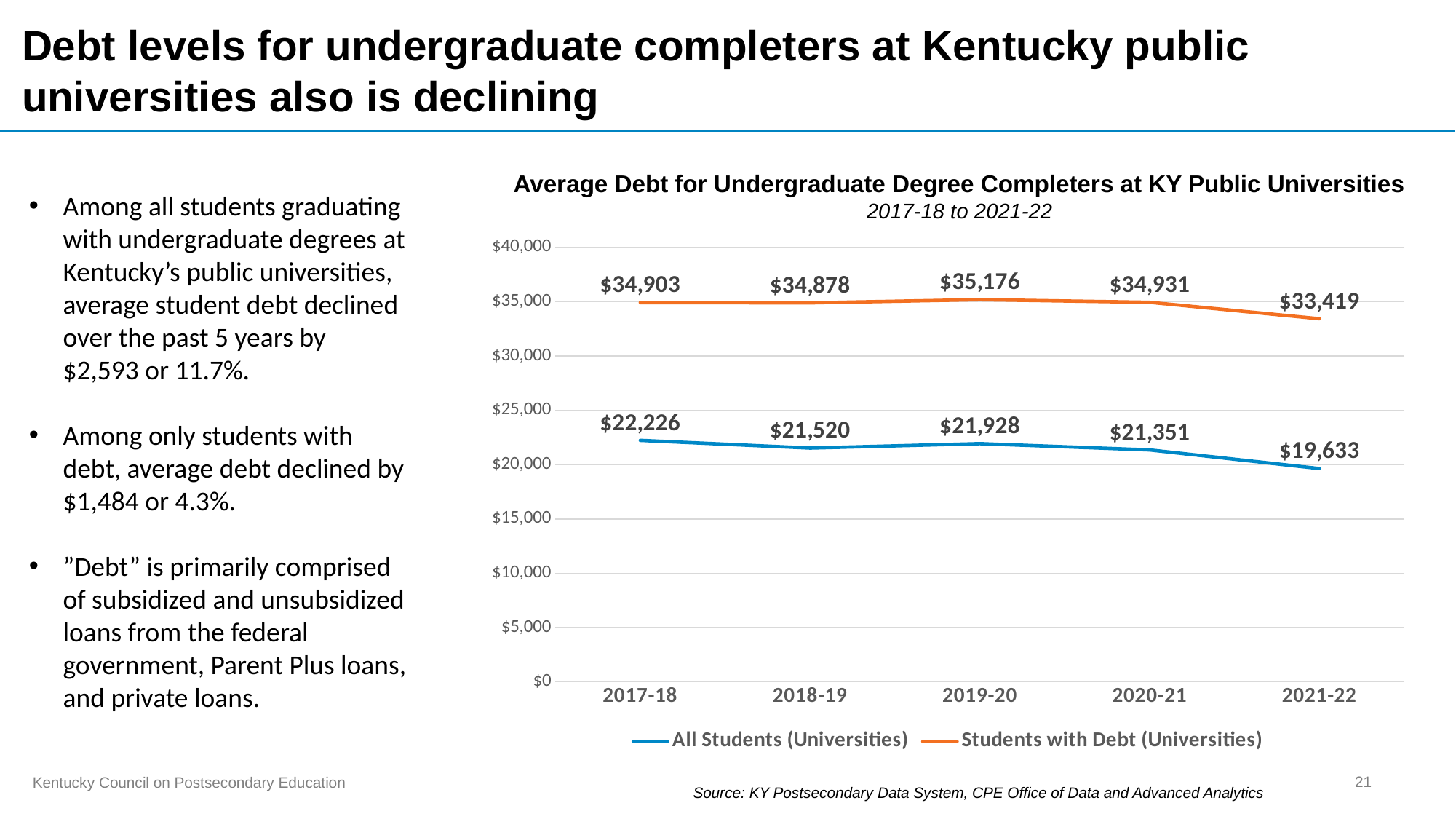
In which year is the average debt for Students with Debt (Universities) lowest? 2021-22 What is the difference between the Students with Debt and All Students values in 2021-22? $13,786 Which is larger: the All Students value in 2018-19 or in 2019-20? 2019-20 Is the value for Students with Debt (Universities) in 2021-22 greater or less than $35,000? less What is the average debt for All Students (Universities) in 2017-18? $22,226 What is the average debt for Students with Debt (Universities) in 2019-20? $35,176 By how much did the average debt for All Students (Universities) change from 2017-18 to 2021-22? $2,593 What kind of chart is shown on the slide? line chart In which year is the average debt for All Students (Universities) highest? 2017-18 What is the average debt for Students with Debt (Universities) in 2021-22? $33,419 How many academic years are shown on the x axis? 5 How many series does the legend list? 2